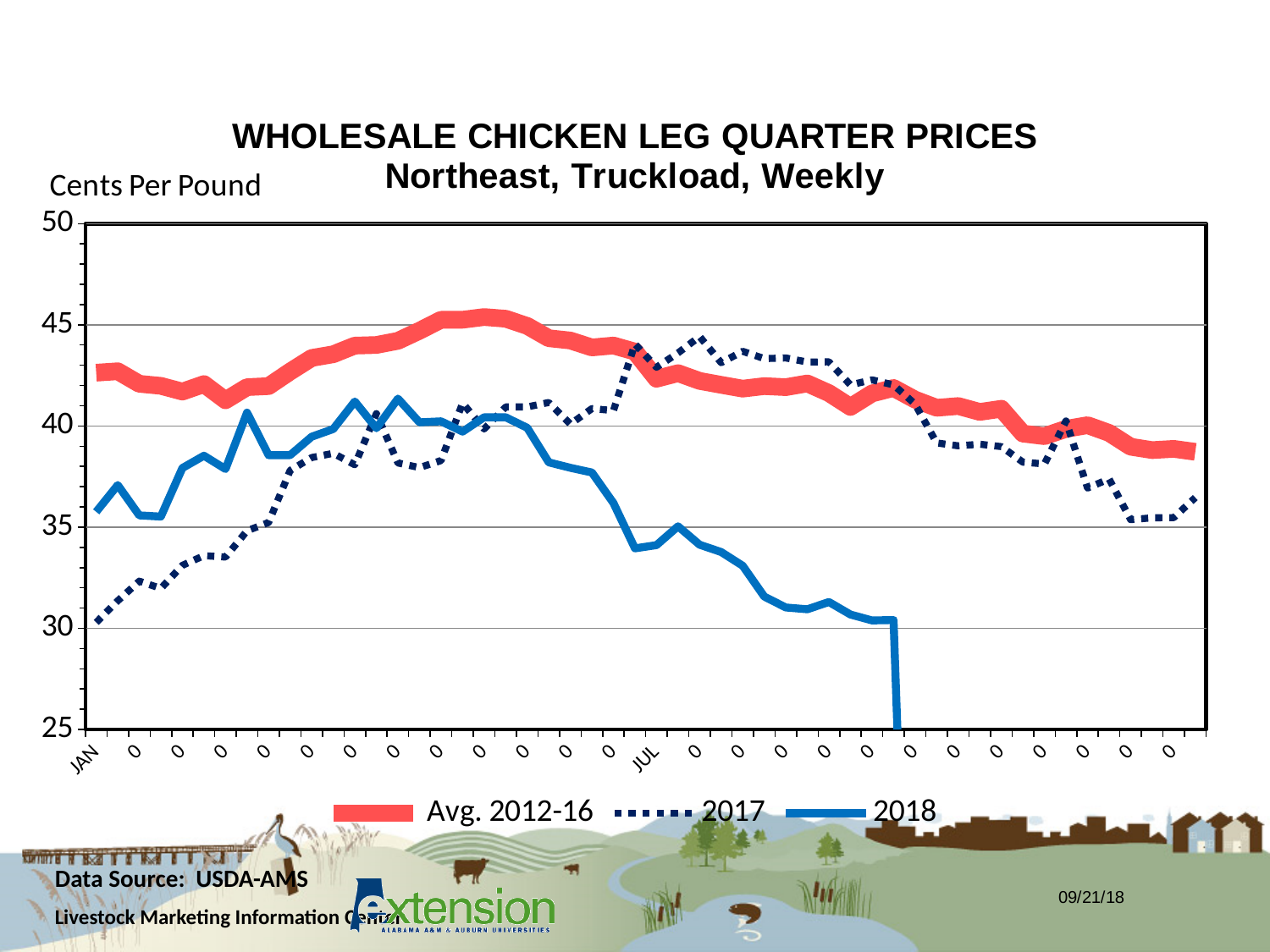
Is the value for the 2018 series at JAN greater or less than 35? greater How many series does the legend list? 3 Is the value for the 2017 series at JUL greater or less than 40? greater What unit is shown on the vertical axis label? Cents Per Pound Is the value for the 2017 series at JAN greater or less than 35? less What kind of chart is shown on the slide? line chart At JAN, which of the three series has the highest value? Avg. 2012-16 At JAN, which series has the higher value, 2017 or 2018? 2018 What are the three series listed in the legend? Avg. 2012-16, 2017, 2018 Does the 2017 series rise or fall between JAN and JUL? rise